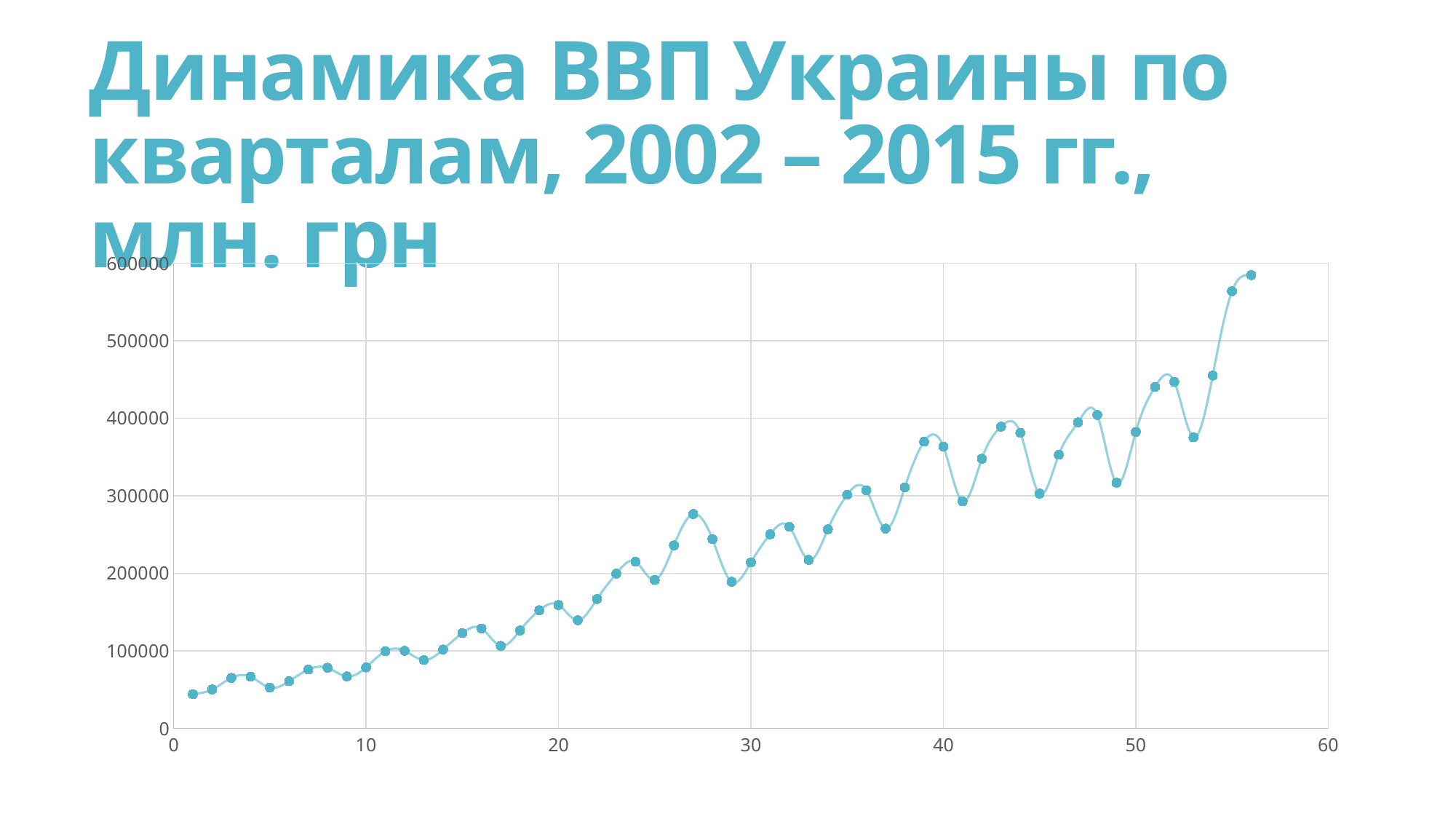
At which x-axis position is the highest point of the line? 56 What is the highest tick label shown on the y axis? 600000 At which x-axis position is the lowest point of the line? 1 Is the value at x = 56 greater or less than 500000? greater Which value is larger, the one at x = 10 or the one at x = 30? x = 30 Is the value at x = 27 greater or less than 300000? less What is the title of the chart? Динамика ВВП Украины по кварталам, 2002 – 2015 гг., млн. грн Is the value at x = 53 greater or less than 400000? less What kind of chart is shown on the slide? line chart Overall, do the values rise or fall along the x axis? rise